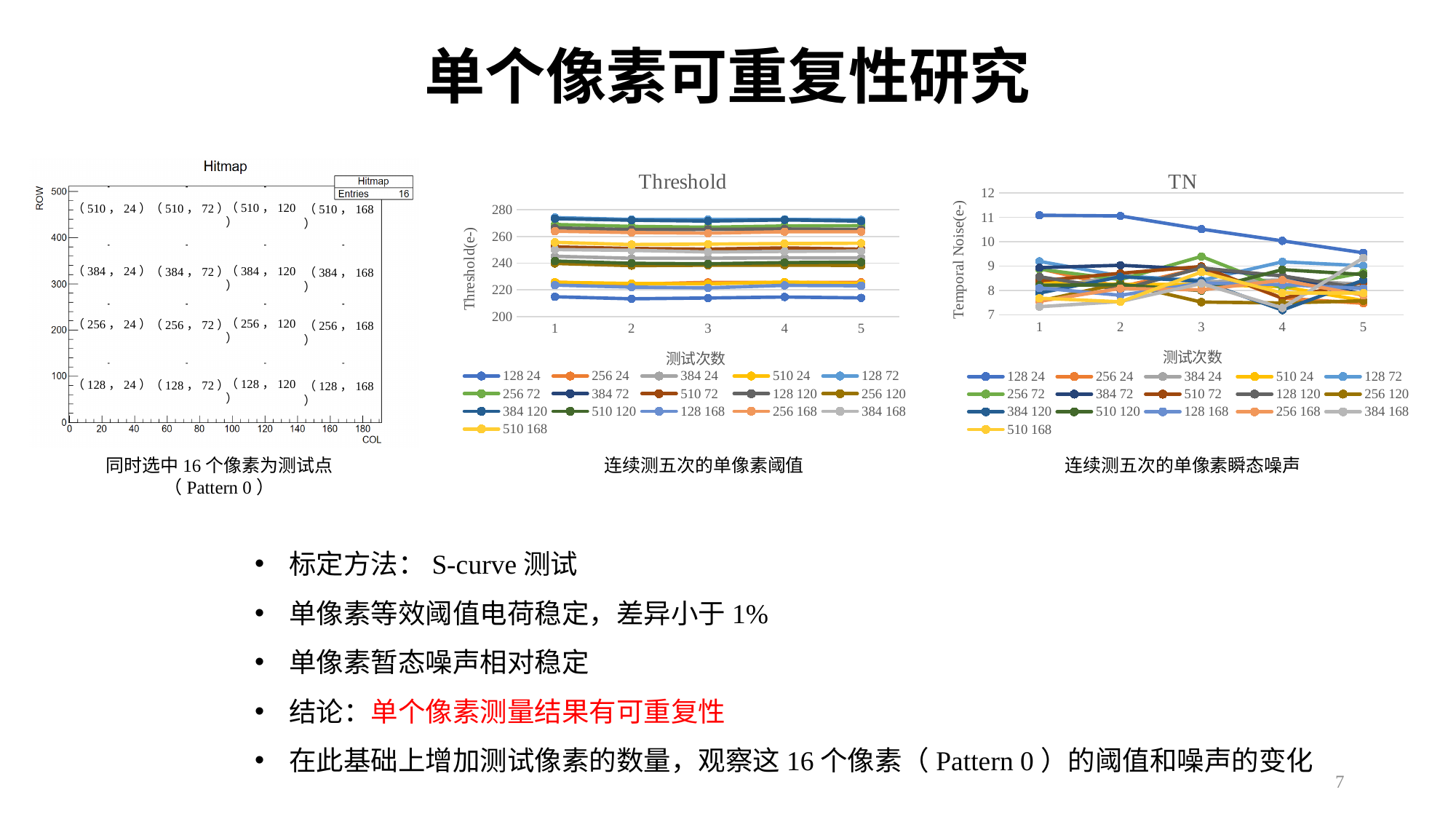
In the TN chart, do the values of series 128 24 rise or fall from test 1 to test 5? fall How many entries does the Hitmap chart report in its statistics box? 16 In the TN chart, which is larger at test 2: the value for 128 24 or the value for 256 24? 128 24 How many series does the legend of the TN chart list? 16 In the TN chart, is the value for series 128 24 at test 1 greater or less than 10? greater In the Threshold chart, is the value for series 384 120 at test 1 greater or less than 260? greater How many test points (测试次数) are shown on the x axis of the Threshold chart? 5 What is the y-axis label of the TN chart? Temporal Noise(e-) In the Threshold chart, which series has the lowest values across all five tests? 128 24 What kind of chart is the Threshold chart? line chart In the TN chart, which series has the highest value at test 1? 128 24 In the Threshold chart, is the value for series 128 24 at test 1 greater or less than 220? less